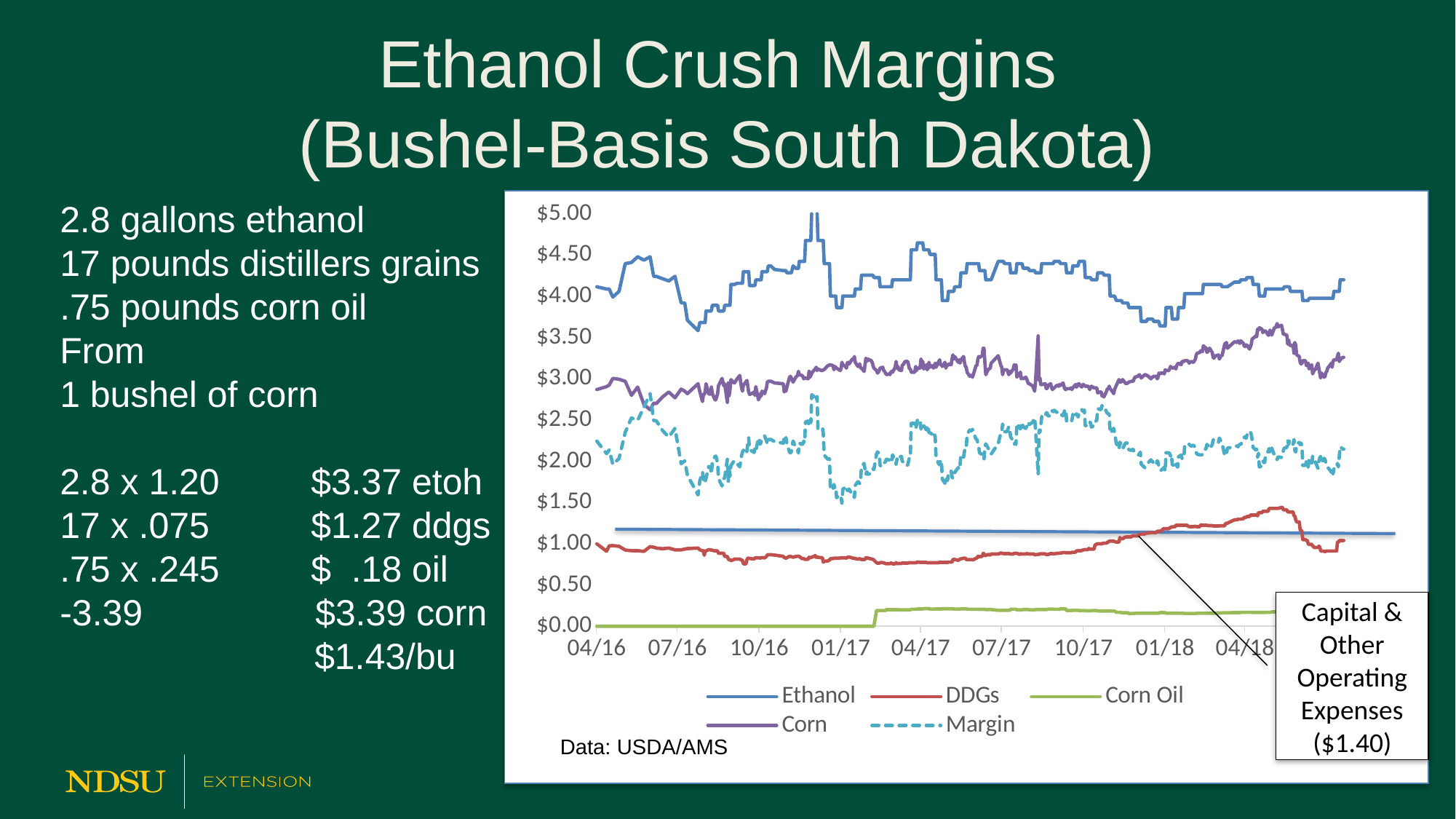
What value is given for Capital & Other Operating Expenses in the chart annotation? $1.40 Which series is drawn with a dashed line in the chart? Margin Is the value for DDGs at 07/17 greater or less than $1.50? less Is the value for Ethanol at 04/16 greater or less than $3.50? greater What data source is cited below the chart? USDA/AMS Which series has the lowest values across the whole chart? Corn Oil Which series is higher throughout the chart, Ethanol or Corn? Ethanol Is the value for Corn Oil at 04/17 greater or less than $0.50? less Does the DDGs series rise or fall between 10/17 and 04/18? rise How many series does the chart legend list? 5 Which series has the highest values across the whole chart? Ethanol What kind of chart is shown on the slide? line chart